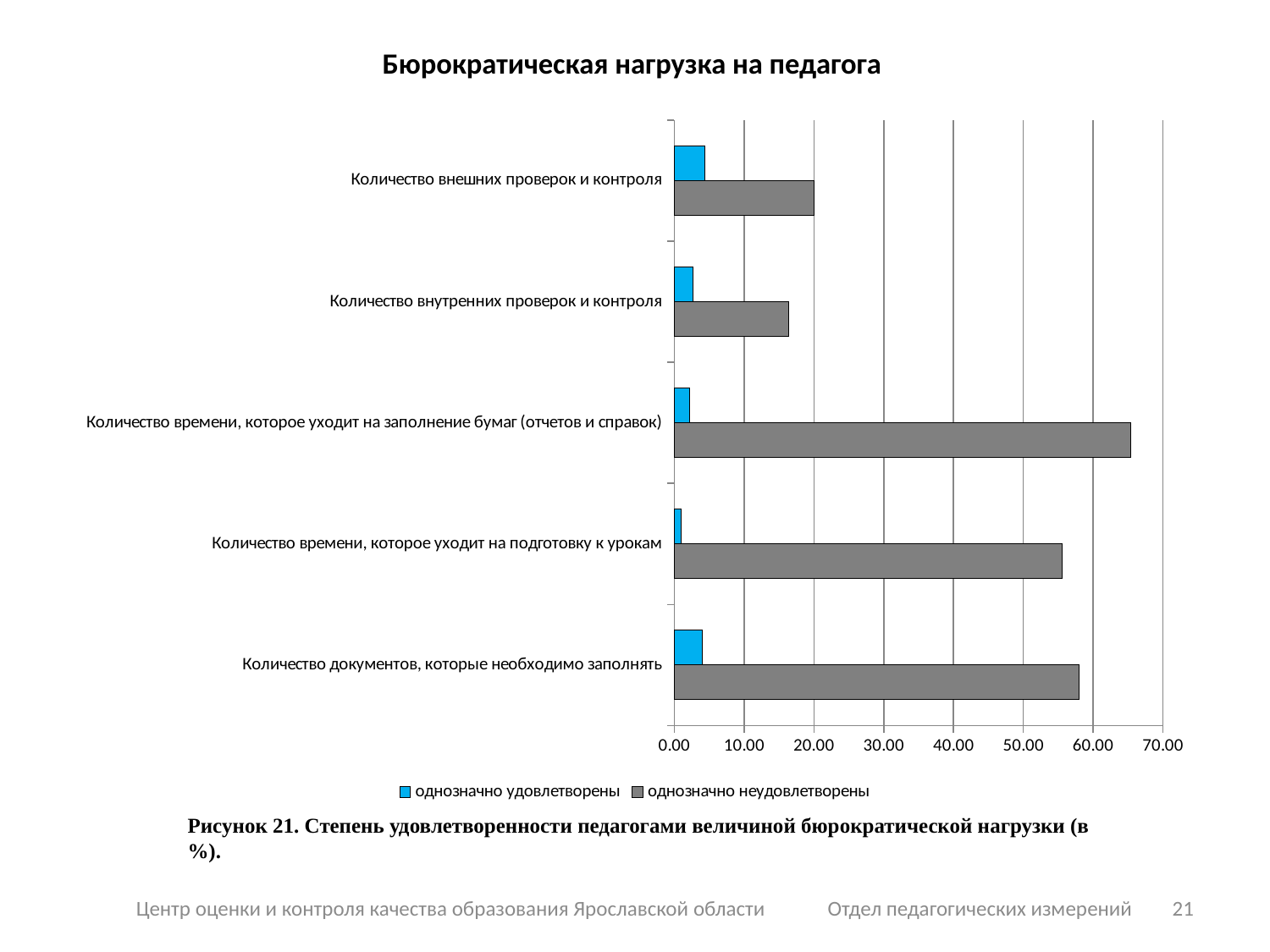
Is the value of "однозначно неудовлетворены" for "Количество внутренних проверок и контроля" greater or less than 20.00? less Is the value of "однозначно удовлетворены" for "Количество внешних проверок и контроля" greater or less than 10.00? less How many series does the legend list? 2 What is the title of the chart? Бюрократическая нагрузка на педагога For "Количество документов, которые необходимо заполнять", which series has the larger value: "однозначно удовлетворены" or "однозначно неудовлетворены"? однозначно неудовлетворены Which category has the highest value for the series "однозначно неудовлетворены"? Количество времени, которое уходит на заполнение бумаг (отчетов и справок) Which category has the lowest value for the series "однозначно удовлетворены"? Количество времени, которое уходит на подготовку к урокам What kind of chart is shown on the slide? bar chart Is the value of "однозначно неудовлетворены" for "Количество времени, которое уходит на заполнение бумаг (отчетов и справок)" greater or less than 60.00? greater How many categories are plotted on the chart? 5 Which category has the lowest value for the series "однозначно неудовлетворены"? Количество внутренних проверок и контроля